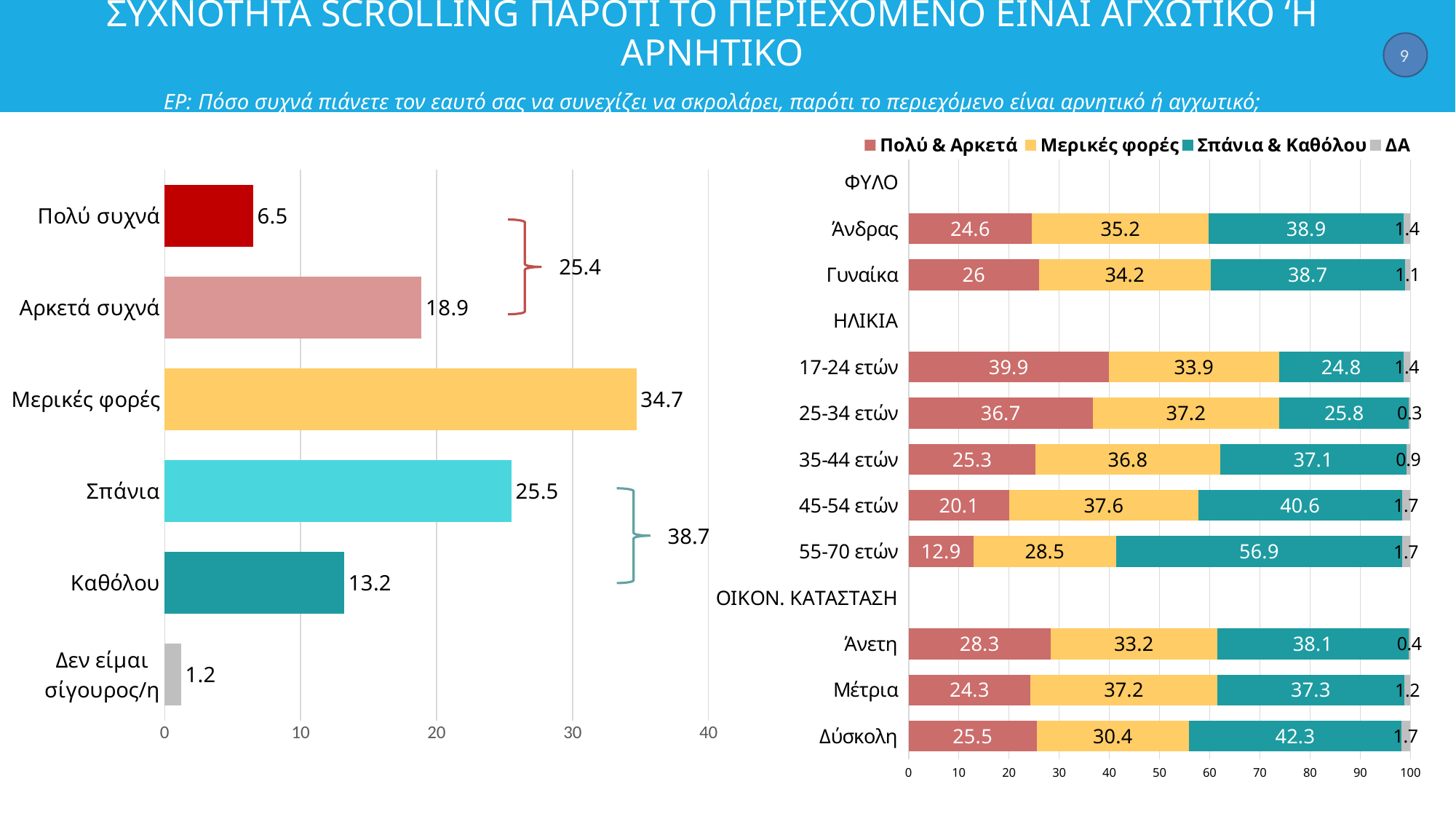
In the right stacked bar chart, how many series does the legend list? 4 In the right stacked bar chart, what is the difference between the Σπάνια & Καθόλου values for Δύσκολη and Άνετη? 4.2 In the left bar chart, which category has the highest value? Μερικές φορές In the left bar chart, how many categories are shown? 6 In the right stacked bar chart, which is larger: the Μερικές φορές value for Άνδρας or for Γυναίκα? Άνδρας In the right stacked bar chart, which age group has the highest Πολύ & Αρκετά value? 17-24 ετών In the left bar chart, which category has the lowest value? Δεν είμαι σίγουρος/η In the right stacked bar chart, what is the Πολύ & Αρκετά value for 17-24 ετών? 39.9 In the left bar chart, what is the value for Μερικές φορές? 34.7 What kind of chart is the chart on the left of the slide? Bar chart In the right stacked bar chart, what is the Σπάνια & Καθόλου value for 55-70 ετών? 56.9 In the left bar chart, what is the difference between Σπάνια and Καθόλου? 12.3